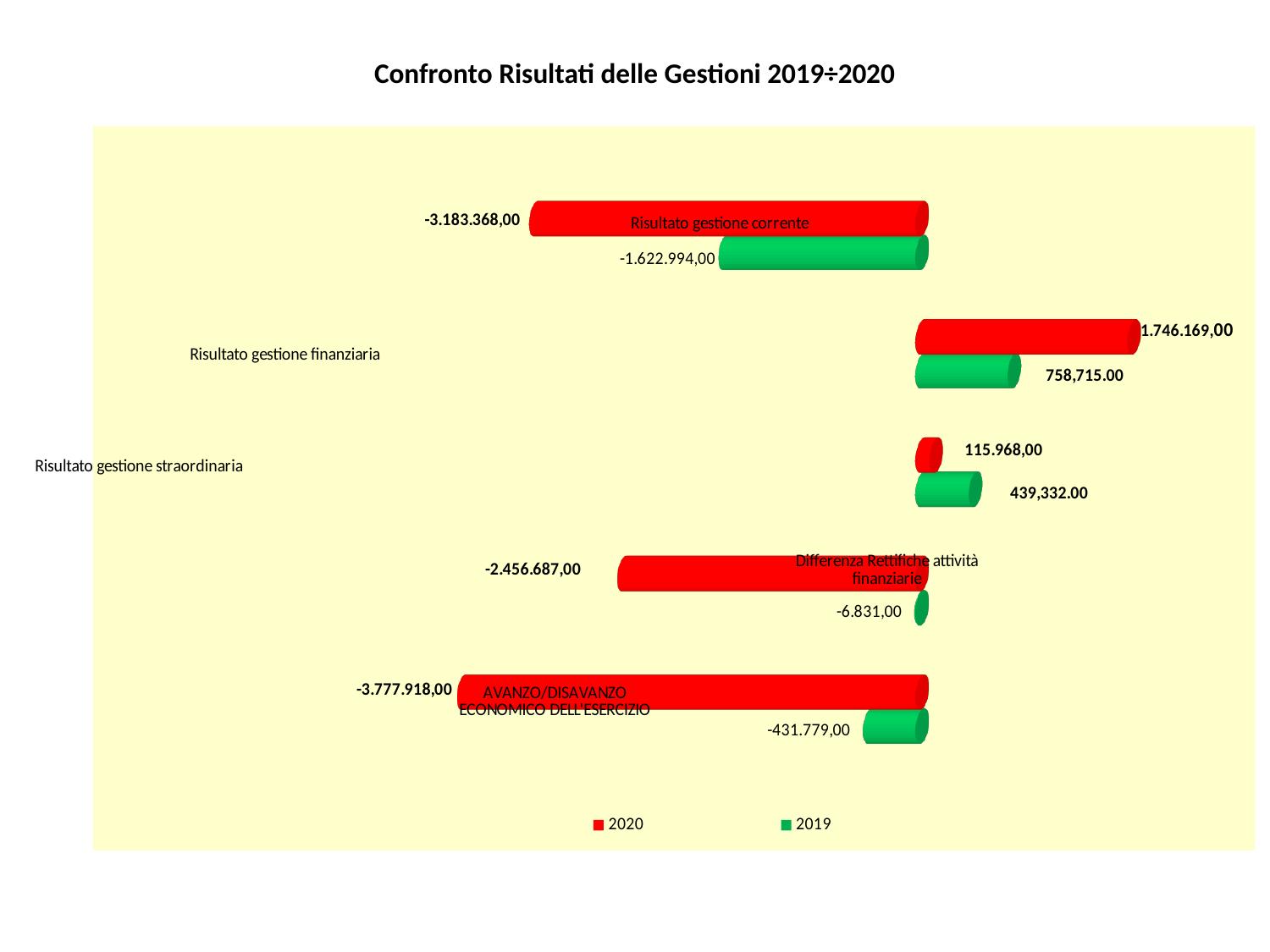
Which category has the highest 2020 value? Risultato gestione finanziaria Which colour represents the 2019 series in the chart? Green What is the 2019 value for Risultato gestione finanziaria? 758,715.00 How many categories are shown in the chart? 5 Which category has the lowest 2020 value? AVANZO/DISAVANZO ECONOMICO DELL'ESERCIZIO What kind of chart is shown on the slide? Bar chart How many series does the legend list? 2 What is the 2019 value for Differenza Rettifiche attività finanziarie? -6.831,00 What is the 2020 value for Risultato gestione corrente? -3.183.368,00 What is the 2020 value for Risultato gestione straordinaria? 115.968,00 What is the 2020 value for AVANZO/DISAVANZO ECONOMICO DELL'ESERCIZIO? -3.777.918,00 For Risultato gestione straordinaria, which year has the larger value, 2020 or 2019? 2019